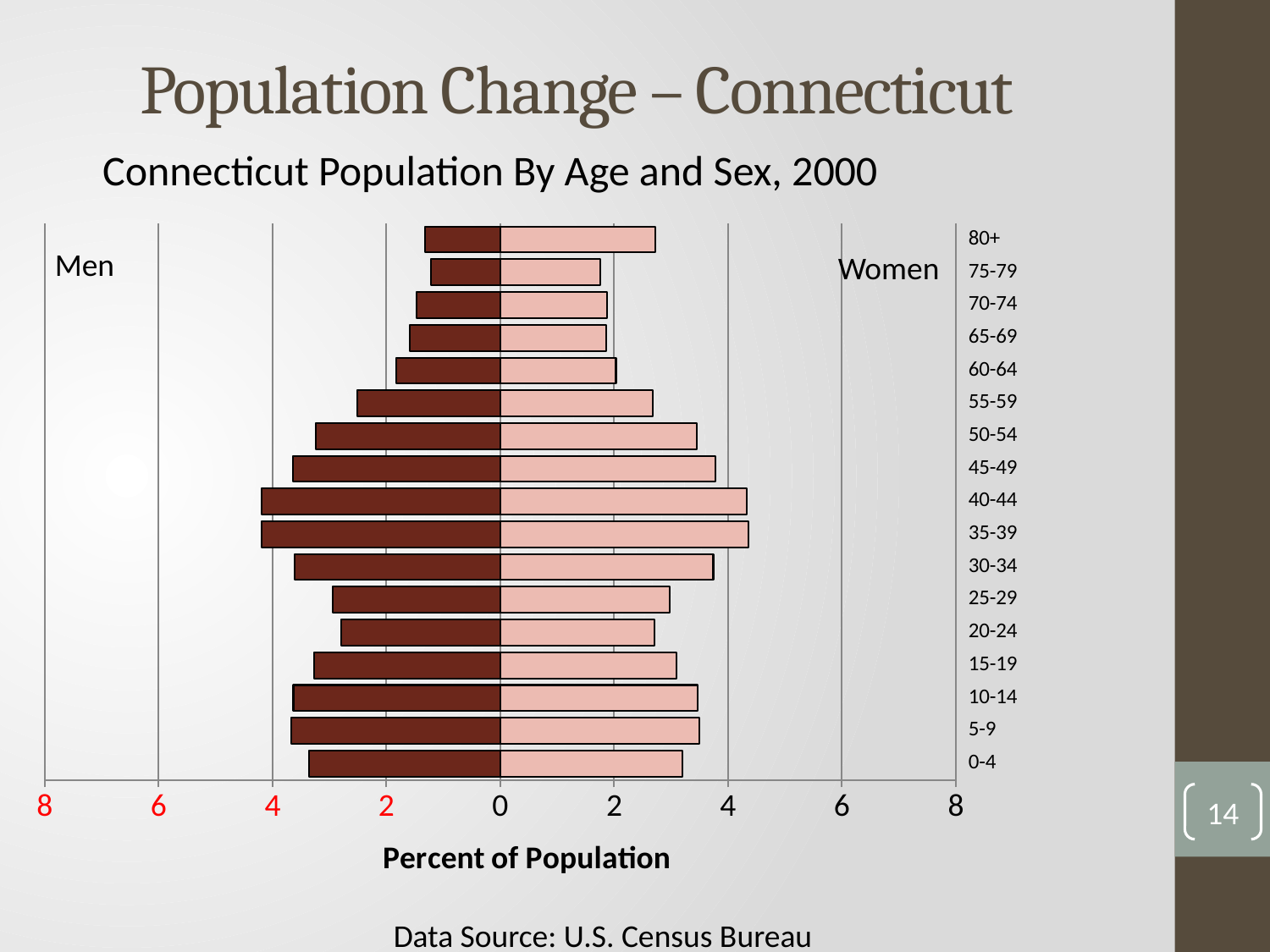
Is the value for Women aged 80+ greater or less than 2? greater For the 80+ age group, which is larger, the value for Men or for Women? Women How many series (sexes) does the chart show? 2 Is the value for Men aged 75-79 greater or less than 2? less For Men, which is larger, the value for ages 40-44 or ages 60-64? 40-44 Is the value for Men aged 35-39 greater or less than 4? greater How many age groups are plotted in the chart? 17 What is the title of the chart? Connecticut Population By Age and Sex, 2000 What kind of chart is shown on the slide? bar chart What is the label of the horizontal axis? Percent of Population